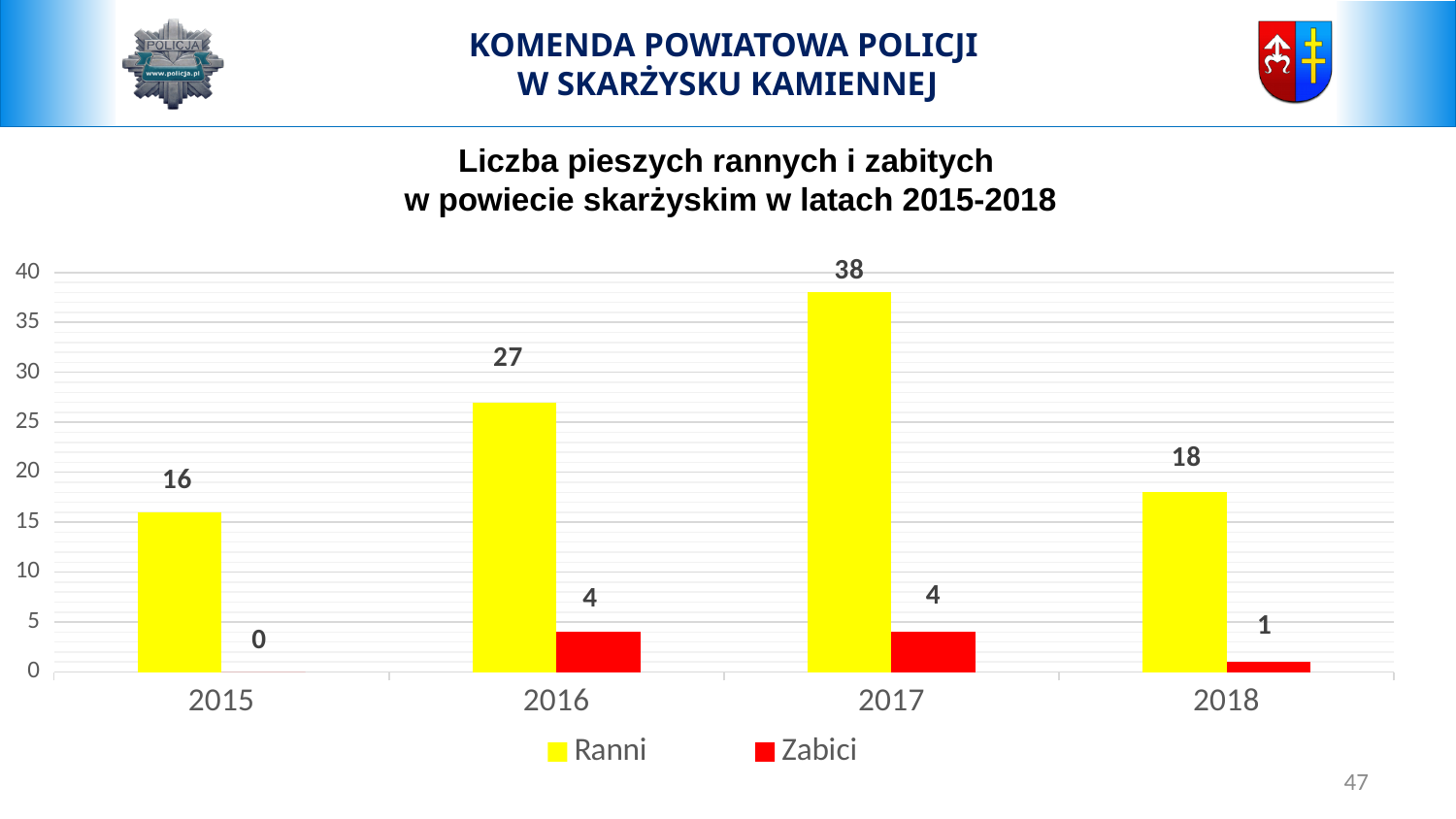
Does the Ranni value rise or fall from 2017 to 2018? Fall What is the value for Zabici in 2018? 1 Which year has the lowest value for Zabici? 2015 What colour are the Zabici bars? Red How many series does the legend list? 2 What is the difference between the Ranni values for 2017 and 2016? 11 How many years are shown on the x axis? 4 Which year has the highest value for Ranni? 2017 Which is larger: Ranni in 2016 or Ranni in 2018? Ranni in 2016 What is the value for Ranni in 2017? 38 What kind of chart is shown on the slide? Bar chart What is the value for Ranni in 2015? 16